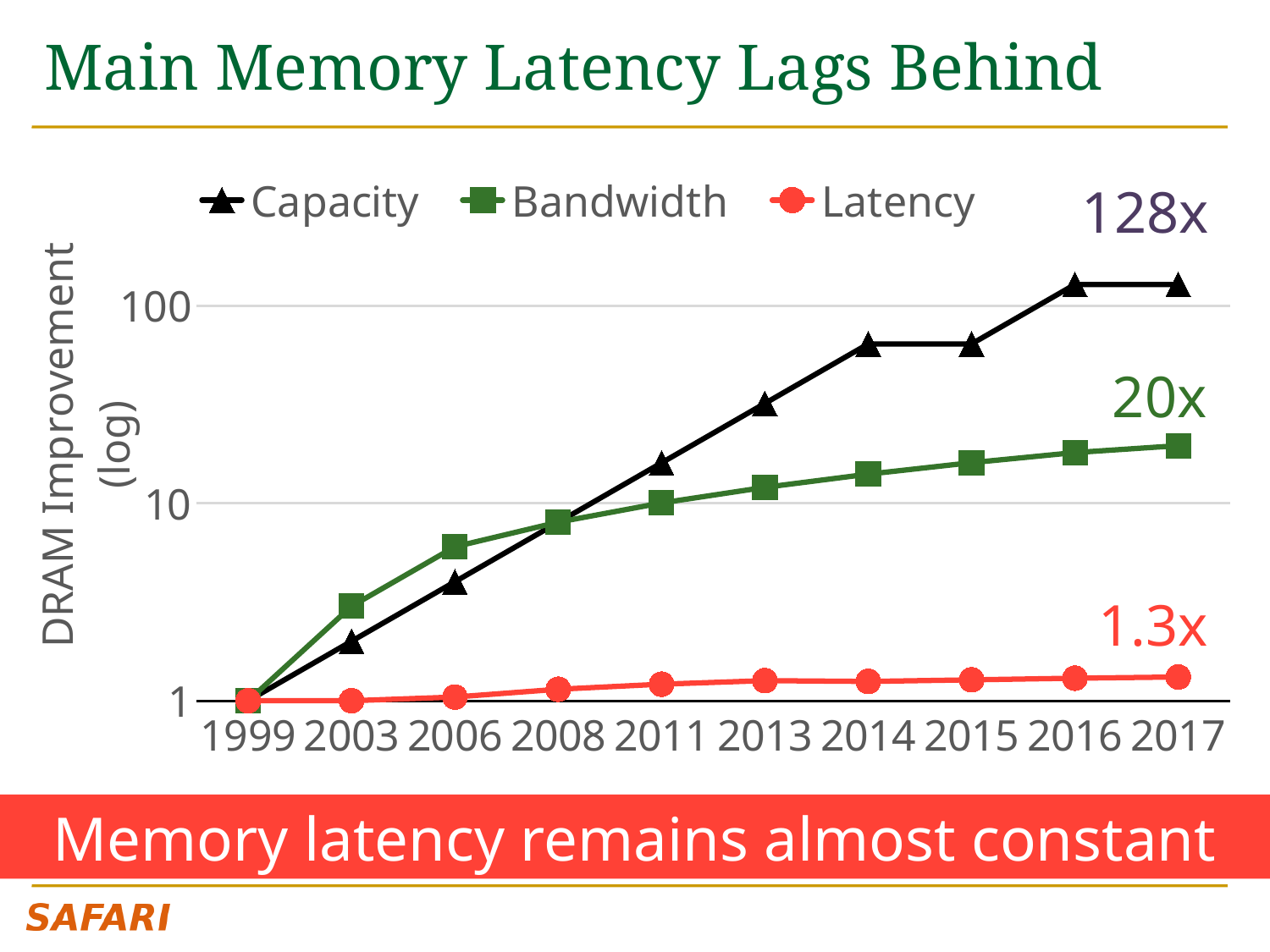
How many years are shown on the x axis? 10 Does the Capacity series rise or fall from 1999 to 2017? rise What is the DRAM latency improvement in 2017? 1.3x In 2006, which is larger, Bandwidth or Capacity? Bandwidth What is the DRAM bandwidth improvement in 2017? 20x What is the label on the y axis? DRAM Improvement (log) How many series does the legend list? 3 Which series has the lowest value in 2017? Latency What kind of chart is shown on the slide? line chart Which series has the highest value in 2017? Capacity What is the DRAM capacity improvement in 2017? 128x Is the Capacity value for 2016 greater or less than 100? greater